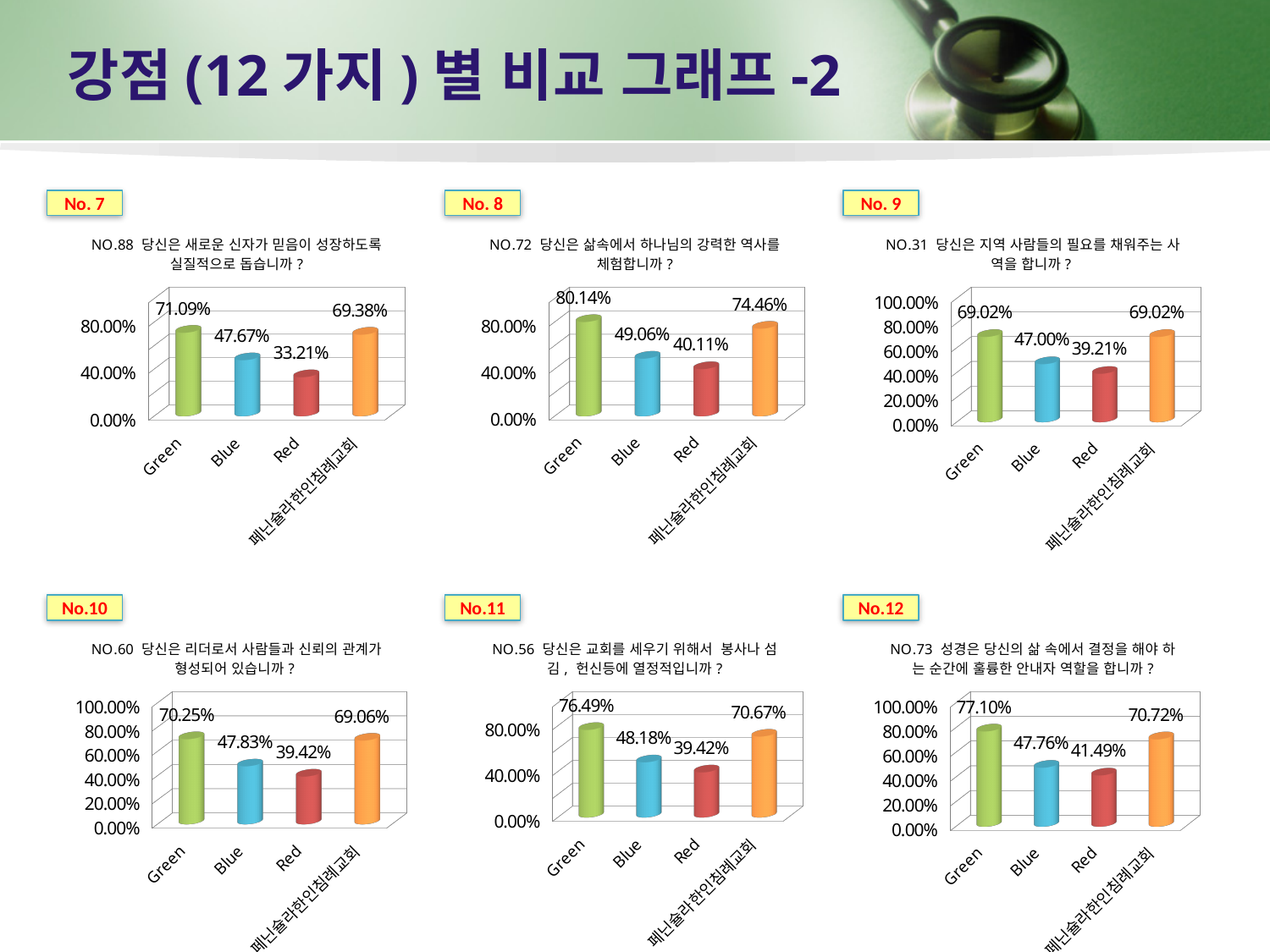
In the No.10 chart (NO.60), which category has the lowest value? Red In the No. 7 chart (NO.88), what is the value for Green? 71.09% In the No. 8 chart (NO.72), what is the value for 페닌슐라한인침례교회? 74.46% In the No. 7 chart (NO.88), which is larger, the value for Blue or the value for Red? Blue In the No. 9 chart (NO.31), what is the value for Blue? 47.00% What kind of chart is the No.10 chart (NO.60)? Bar chart In the No. 8 chart (NO.72), what is the difference between the Green value and the Red value? 40.03% In the No.12 chart (NO.73), what is the value for Red? 41.49% In the No.11 chart (NO.56), which category has the highest value? Green How many charts are shown on the slide? 6 How many categories are shown on the x axis of the No. 9 chart (NO.31)? 4 In the No.12 chart (NO.73), is the value for Green greater or less than 60.00%? greater